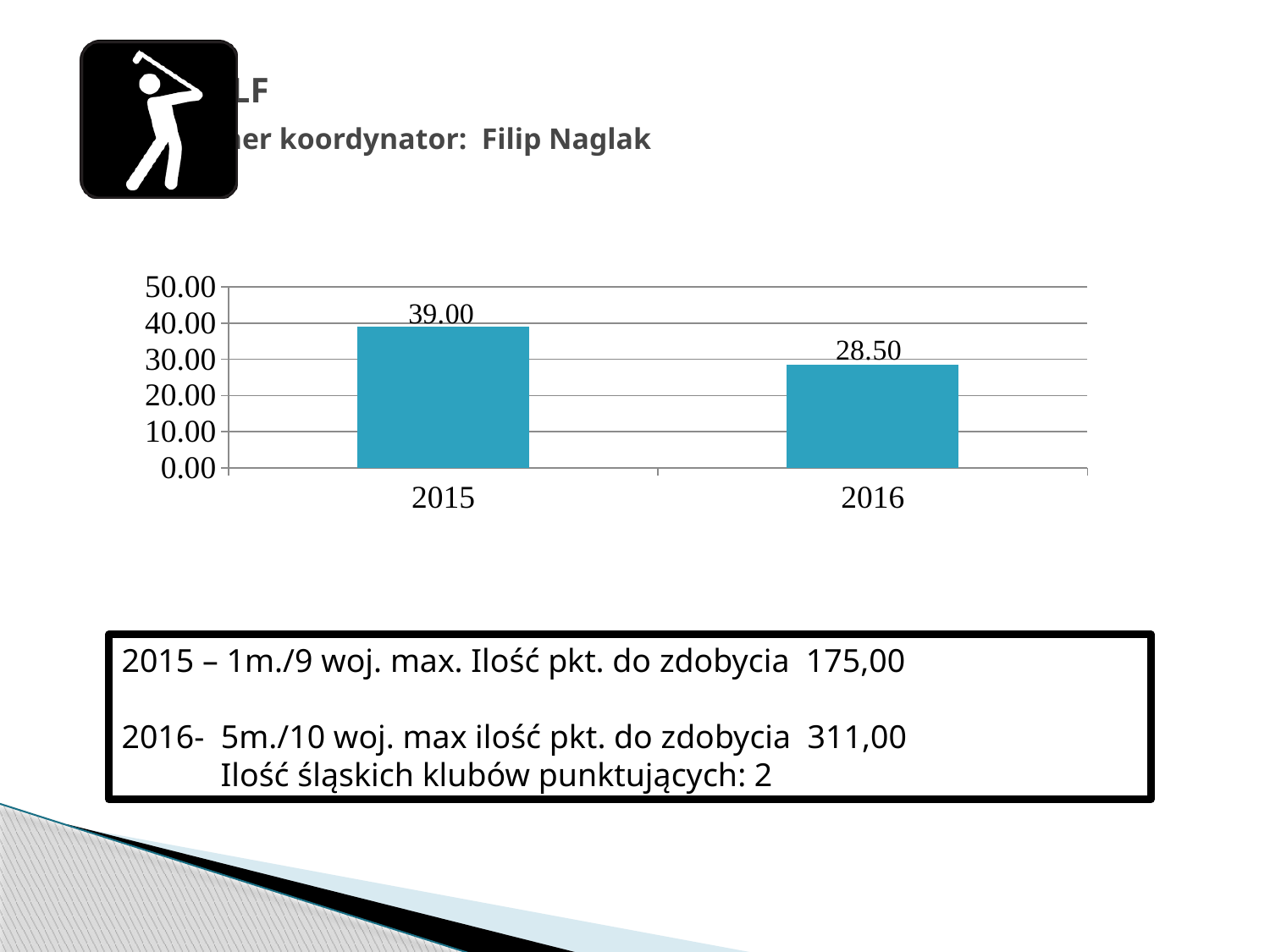
What is the difference between the values for 2015 and 2016? 10.50 What is the maximum value shown on the y axis? 50.00 Is the value for 2016 greater or less than 30.00? less What kind of chart is shown on the slide? bar chart What is the value for 2016? 28.50 How many categories are shown on the x axis? 2 Which is larger, the value for 2015 or the value for 2016? 2015 Do the values rise or fall from 2015 to 2016? fall Is the value for 2015 greater or less than 30.00? greater What is the value for 2015? 39.00 Which year has the highest value? 2015 Which year has the lowest value? 2016